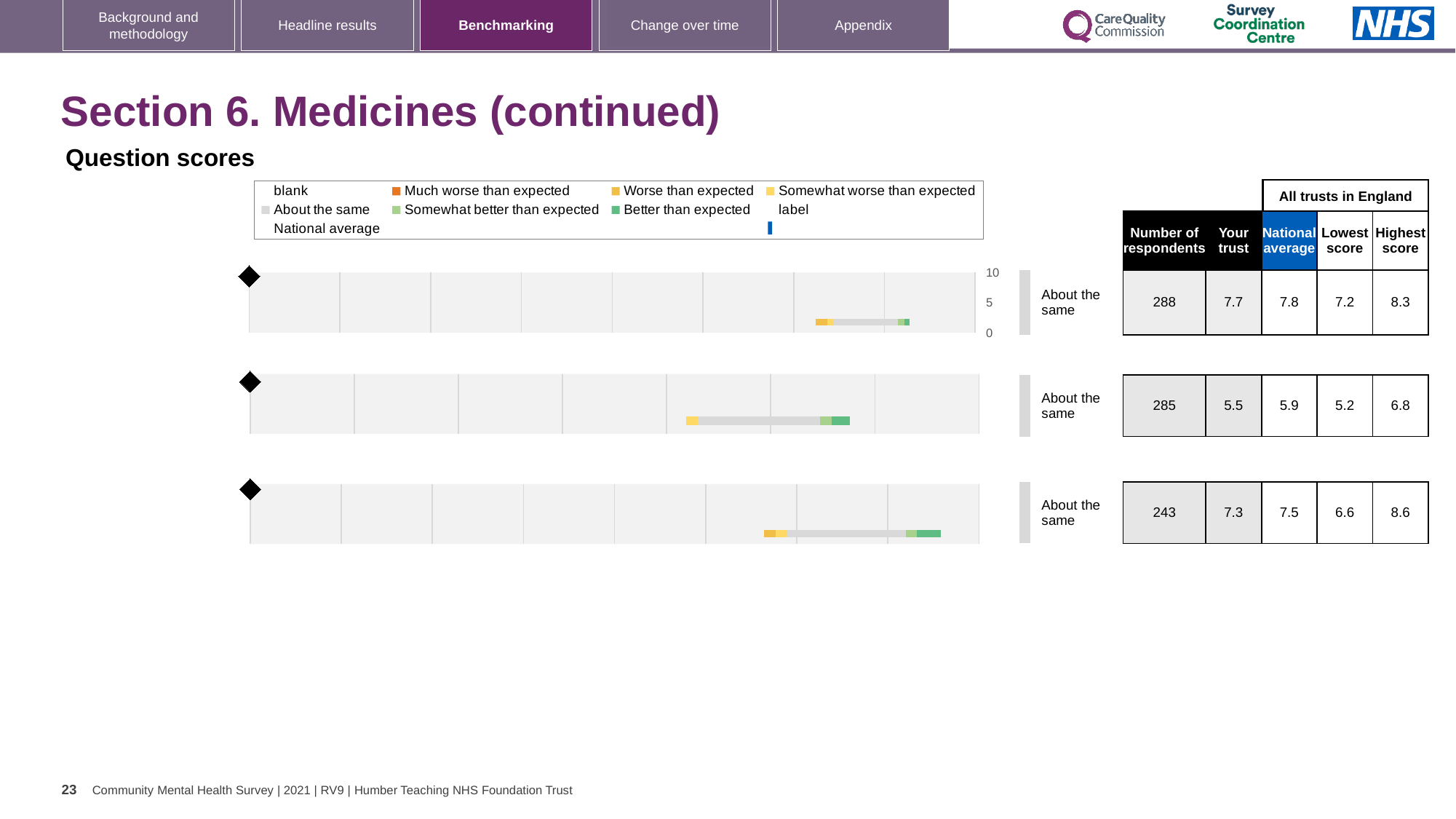
Which chart (top, middle or bottom) has the lowest national average score? middle What kind of chart is used for the question scores on this slide? bar chart Which chart (top, middle or bottom) has the highest 'Your trust' score? top For the bottom chart, what is the difference between the highest score and the lowest score across all trusts in England? 2.0 For the top chart, what is the 'Your trust' score? 7.7 What is the maximum value shown on the score axis of the top chart? 10 For the bottom chart, how many respondents are there? 243 How many question score charts are shown on the slide? 3 What benchmark category label is shown next to each of the three charts? About the same For the middle chart, is the 'Your trust' score greater or less than 5? greater For the top chart, which is larger: the 'Your trust' score or the national average? National average For the middle chart, what is the national average score? 5.9